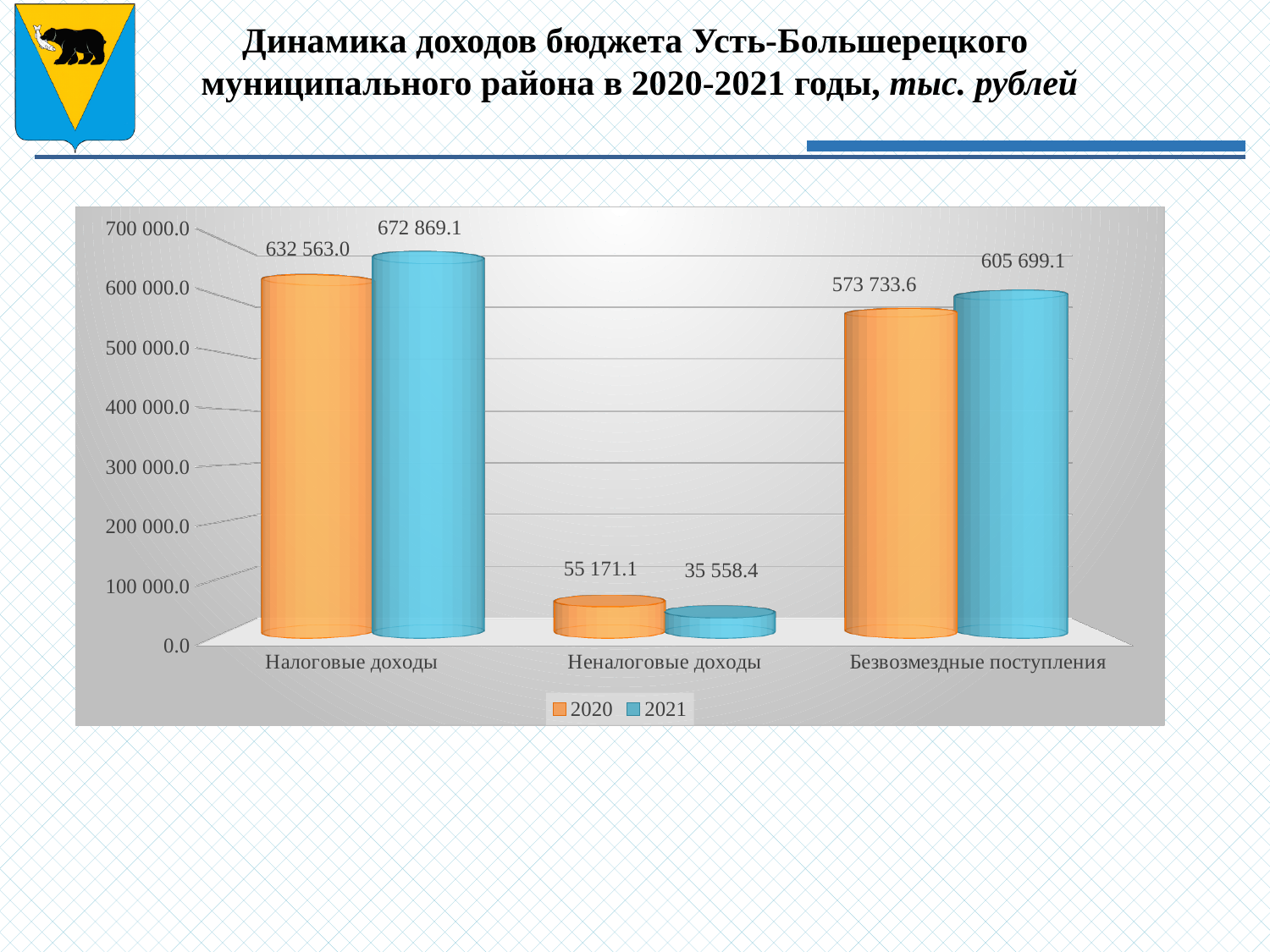
What is the value for Неналоговые доходы in 2021? 35 558.4 What is the value for Безвозмездные поступления in 2021? 605 699.1 Which category has the lowest value in 2020? Неналоговые доходы What is the difference between the 2020 and 2021 values for Неналоговые доходы? 19 612.7 Which category has the highest value in 2021? Налоговые доходы What kind of chart is shown on the slide? Bar chart What is the value for Налоговые доходы in 2020? 632 563.0 Which is larger for Безвозмездные поступления: the 2020 value or the 2021 value? 2021 What is the difference between the 2021 and 2020 values for Налоговые доходы? 40 306.1 How many series does the legend list? 2 Is the 2020 value for Безвозмездные поступления greater or less than 500 000.0? greater How many categories are shown on the x axis? 3